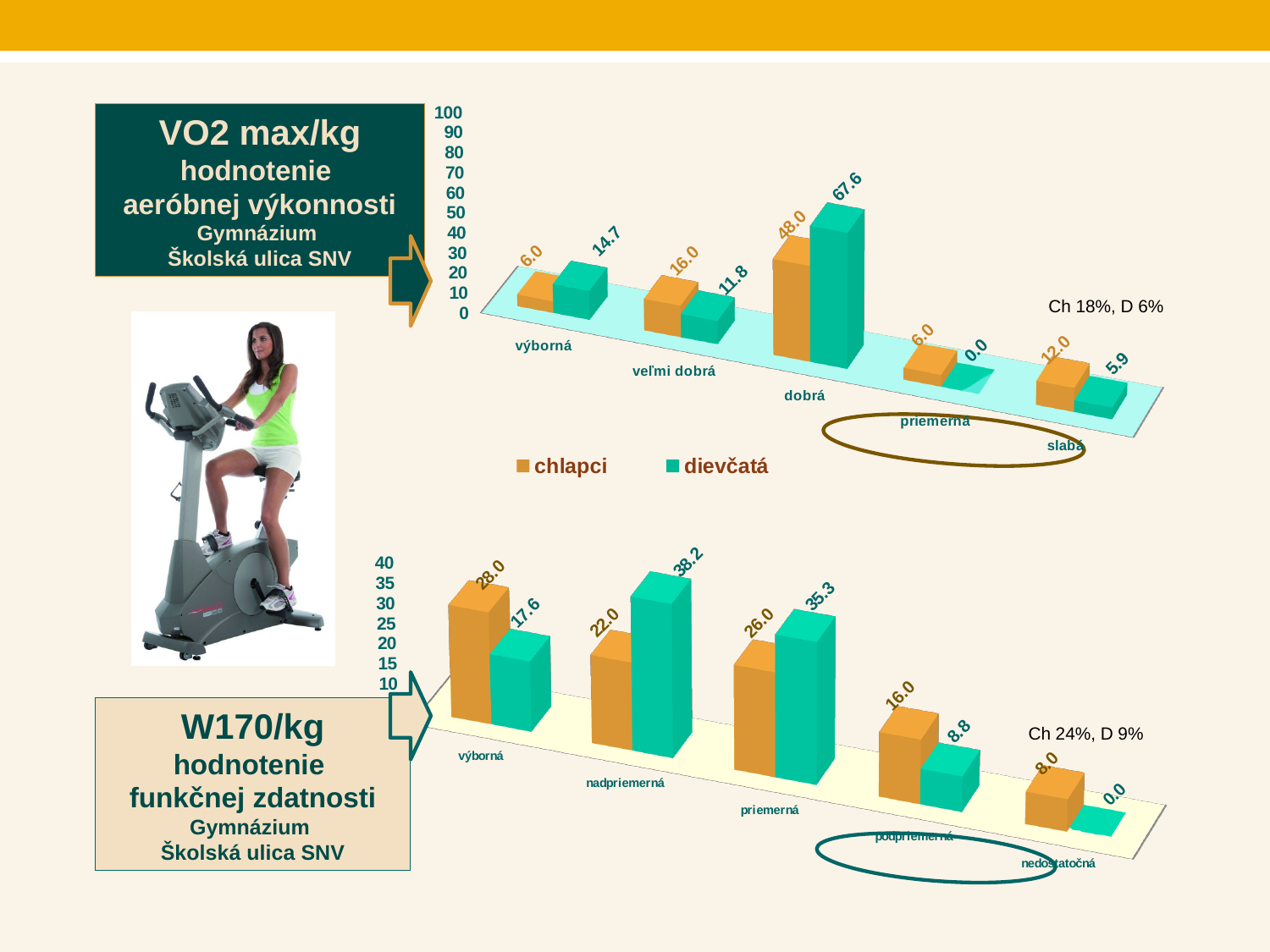
In the W170/kg chart, which category has the lowest value for the green (dievčatá) series? nedostatočná In the W170/kg chart, what is the difference between the orange (chlapci) and green (dievčatá) values in the výborná category? 10.4 In the W170/kg chart, which is larger in the priemerná category, the orange (chlapci) bar or the green (dievčatá) bar? dievčatá What kind of chart is the W170/kg chart? bar chart In the W170/kg chart, what is the value for the green (dievčatá) bar in the nadpriemerná category? 38.2 In the VO2 max/kg chart, what is the value for chlapci in the veľmi dobrá category? 16.0 How many categories are shown on the x axis of the VO2 max/kg chart? 5 In the VO2 max/kg chart, which category has the highest value for chlapci? dobrá In the VO2 max/kg chart, which is larger in the výborná category, chlapci or dievčatá? dievčatá In the VO2 max/kg chart, what is the difference between the dievčatá and chlapci values in the dobrá category? 19.6 How many series does the legend list for the VO2 max/kg chart? 2 In the VO2 max/kg chart, what is the value for dievčatá in the dobrá category? 67.6